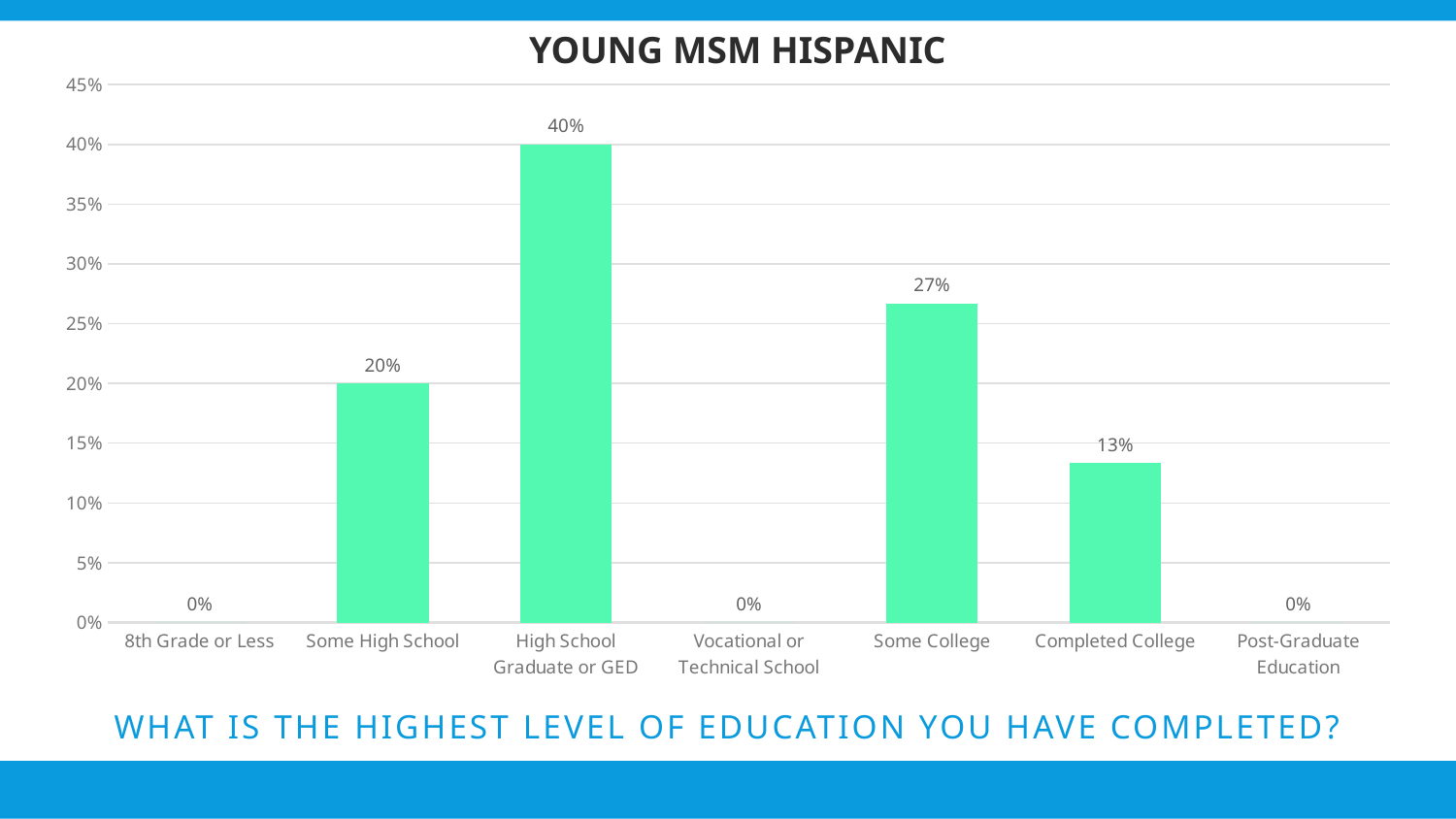
What kind of chart is shown on the slide? Bar chart Which is larger, the value for Some College or the value for Some High School? Some College Which category has the highest value? High School Graduate or GED What is the difference between the values for High School Graduate or GED and Some College? 13% What is the difference between the values for Some High School and Completed College? 7% What is the value for Some College? 27% What is the title of the chart? YOUNG MSM HISPANIC What is the value for High School Graduate or GED? 40% Is the value for Some College greater or less than 25%? greater How many categories are shown on the x axis? 7 What is the value for Completed College? 13% What is the value for Some High School? 20%